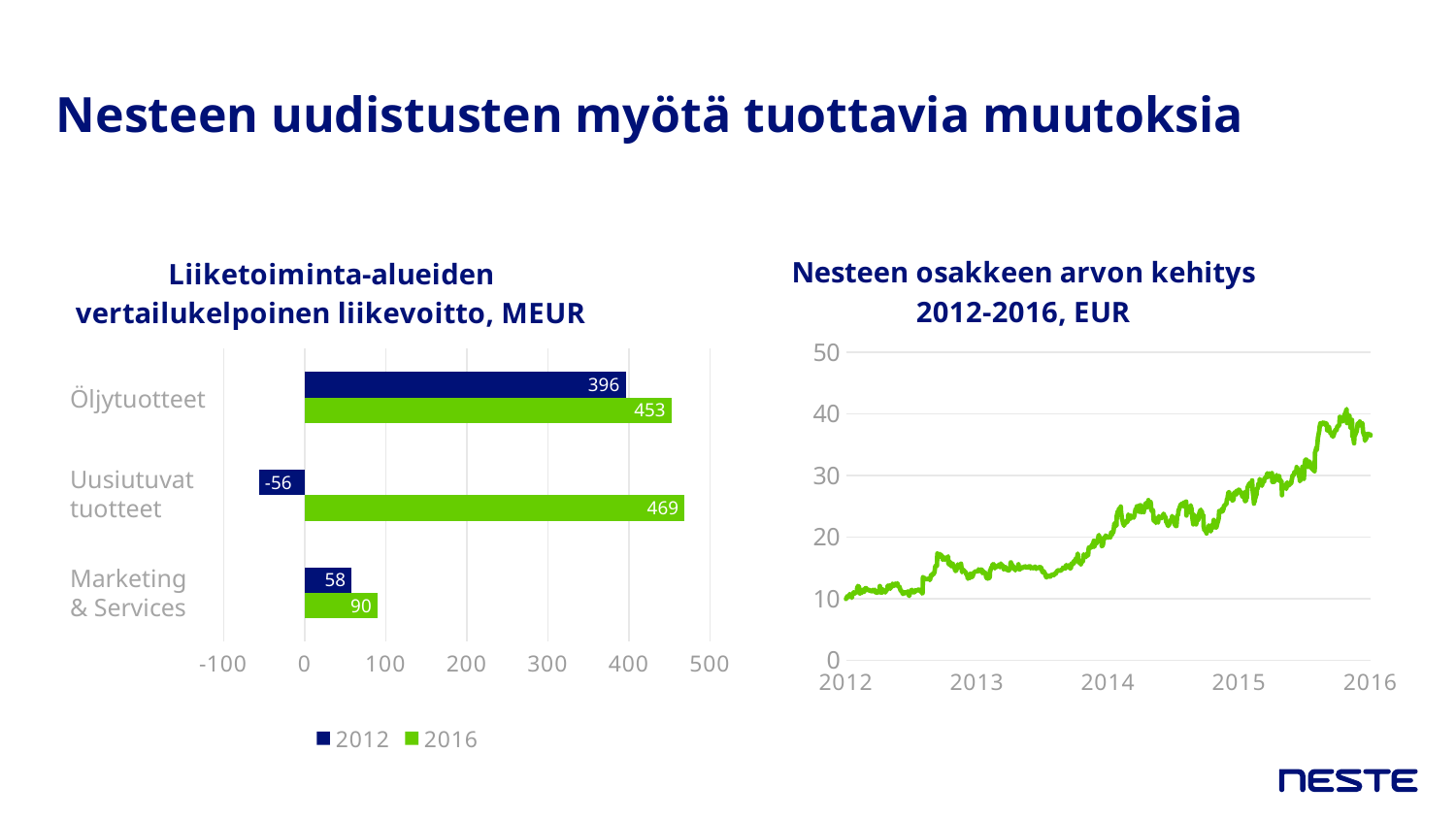
How many series does the legend of the chart 'Liiketoiminta-alueiden vertailukelpoinen liikevoitto, MEUR' list? 2 In the chart 'Liiketoiminta-alueiden vertailukelpoinen liikevoitto, MEUR', what is the difference between the 2016 and 2012 values for Öljytuotteet? 57 In the chart 'Liiketoiminta-alueiden vertailukelpoinen liikevoitto, MEUR', which category has the highest 2016 value? Uusiutuvat tuotteet In the chart 'Liiketoiminta-alueiden vertailukelpoinen liikevoitto, MEUR', what is the 2012 value for Uusiutuvat tuotteet? -56 In the chart 'Liiketoiminta-alueiden vertailukelpoinen liikevoitto, MEUR', which is larger: the 2016 value for Öljytuotteet or the 2016 value for Uusiutuvat tuotteet? Uusiutuvat tuotteet In the chart 'Liiketoiminta-alueiden vertailukelpoinen liikevoitto, MEUR', what is the difference between the 2016 and 2012 values for Marketing & Services? 32 In the chart 'Nesteen osakkeen arvon kehitys 2012-2016, EUR', is the value at the start of 2012 greater or less than 20? less In the chart 'Nesteen osakkeen arvon kehitys 2012-2016, EUR', do the values generally rise or fall from 2012 to 2016? Rise What kind of chart is 'Nesteen osakkeen arvon kehitys 2012-2016, EUR'? Line chart In the chart 'Liiketoiminta-alueiden vertailukelpoinen liikevoitto, MEUR', which category has the lowest 2012 value? Uusiutuvat tuotteet In the chart 'Liiketoiminta-alueiden vertailukelpoinen liikevoitto, MEUR', what is the 2016 value for Uusiutuvat tuotteet? 469 In the chart 'Liiketoiminta-alueiden vertailukelpoinen liikevoitto, MEUR', what is the 2012 value for Öljytuotteet? 396